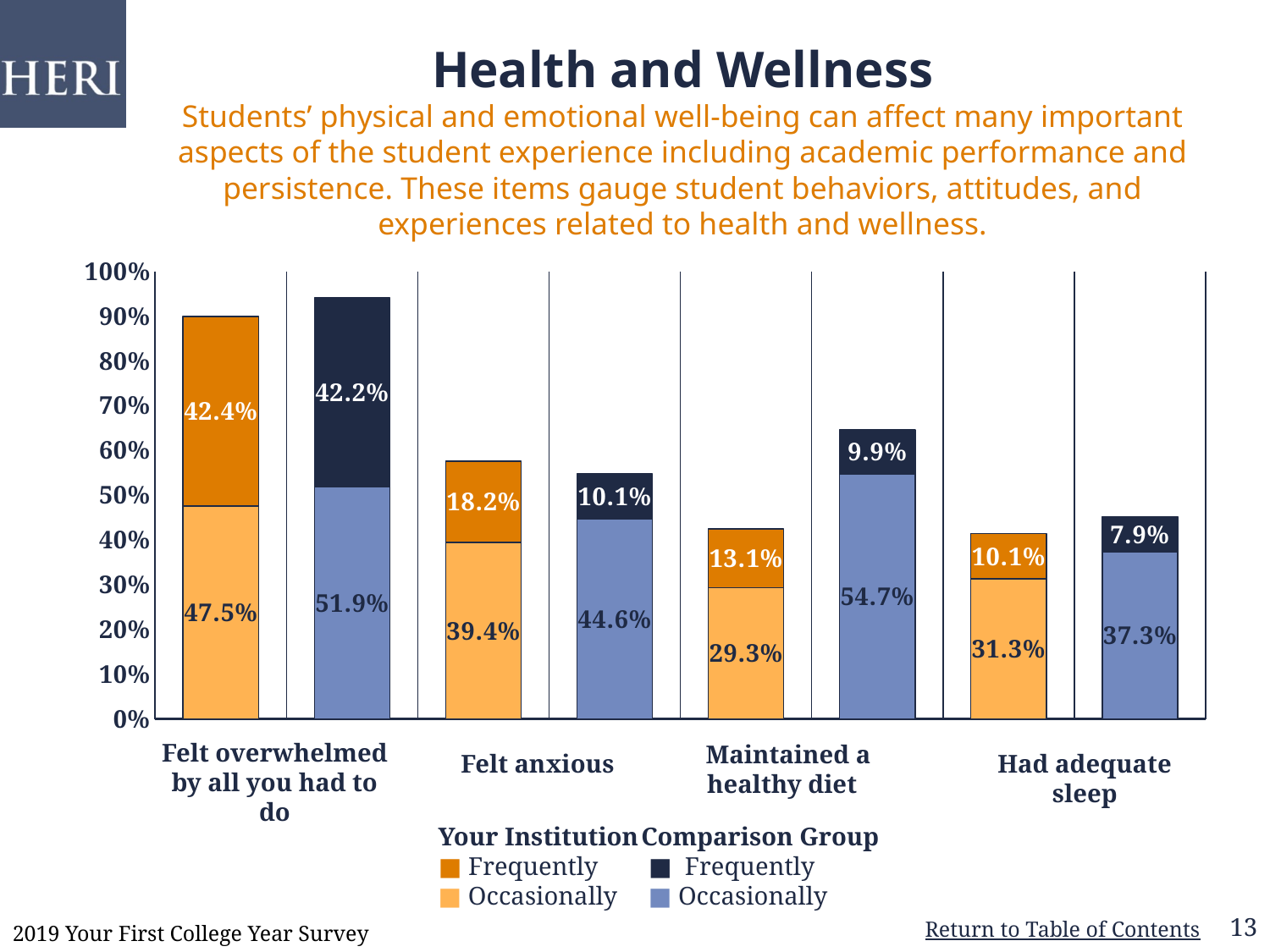
What is the total stacked percentage (Occasionally plus Frequently) for the Comparison Group for 'Maintained a healthy diet'? 64.6% Among the 'Occasionally' values for the Comparison Group, which category is the highest? Maintained a healthy diet What kind of chart is shown on the slide? Stacked bar chart What is the difference between the Comparison Group's 'Occasionally' value and Your Institution's 'Occasionally' value for 'Felt overwhelmed by all you had to do'? 4.4% How many categories are shown on the x axis of the chart? 4 What percentage of students at Your Institution reported 'Frequently' feeling overwhelmed by all they had to do? 42.4% What percentage of the Comparison Group reported 'Occasionally' maintaining a healthy diet? 54.7% What percentage of students at Your Institution reported 'Occasionally' having adequate sleep? 31.3% What is the total stacked percentage (Occasionally plus Frequently) for Your Institution for 'Felt anxious'? 57.6% How many series does the chart legend list? 4 Among the 'Frequently' values for Your Institution, which category is the lowest? Had adequate sleep Which is larger for 'Felt anxious': the 'Frequently' value for Your Institution or for the Comparison Group? Your Institution